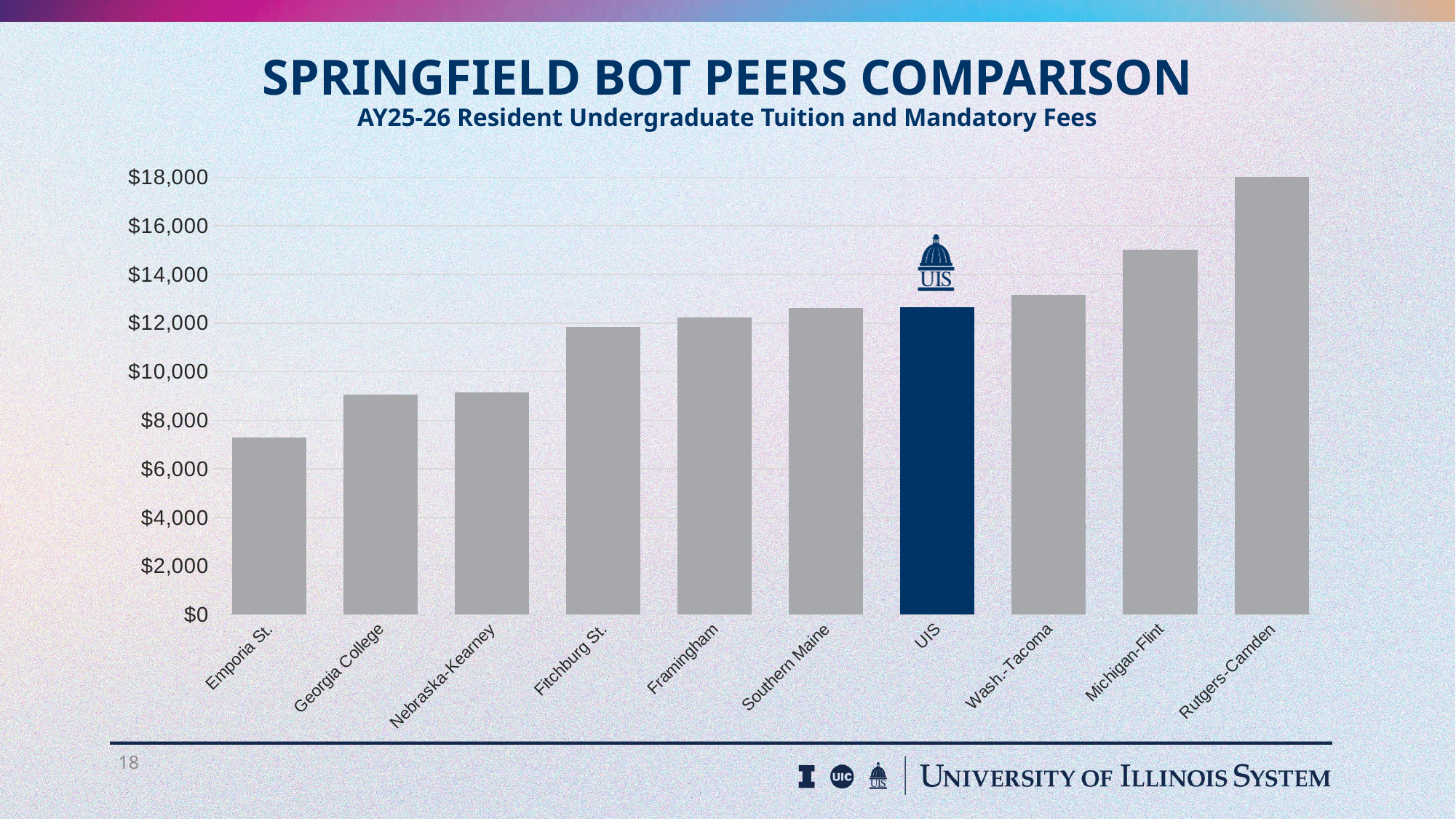
Is the value for Georgia College greater or less than $10,000? less Which institution has the lowest resident undergraduate tuition and mandatory fees? Emporia St. Is the value for Rutgers-Camden greater or less than $16,000? greater Which institution's bar is highlighted in dark blue? UIS Is the value for Emporia St. greater or less than $8,000? less Do the values generally rise or fall from left to right across the chart? rise How many institutions are shown on the chart? 10 What kind of chart is shown on the slide? bar chart Which institution has the highest resident undergraduate tuition and mandatory fees? Rutgers-Camden Which is larger, the value for Michigan-Flint or the value for Wash.-Tacoma? Michigan-Flint